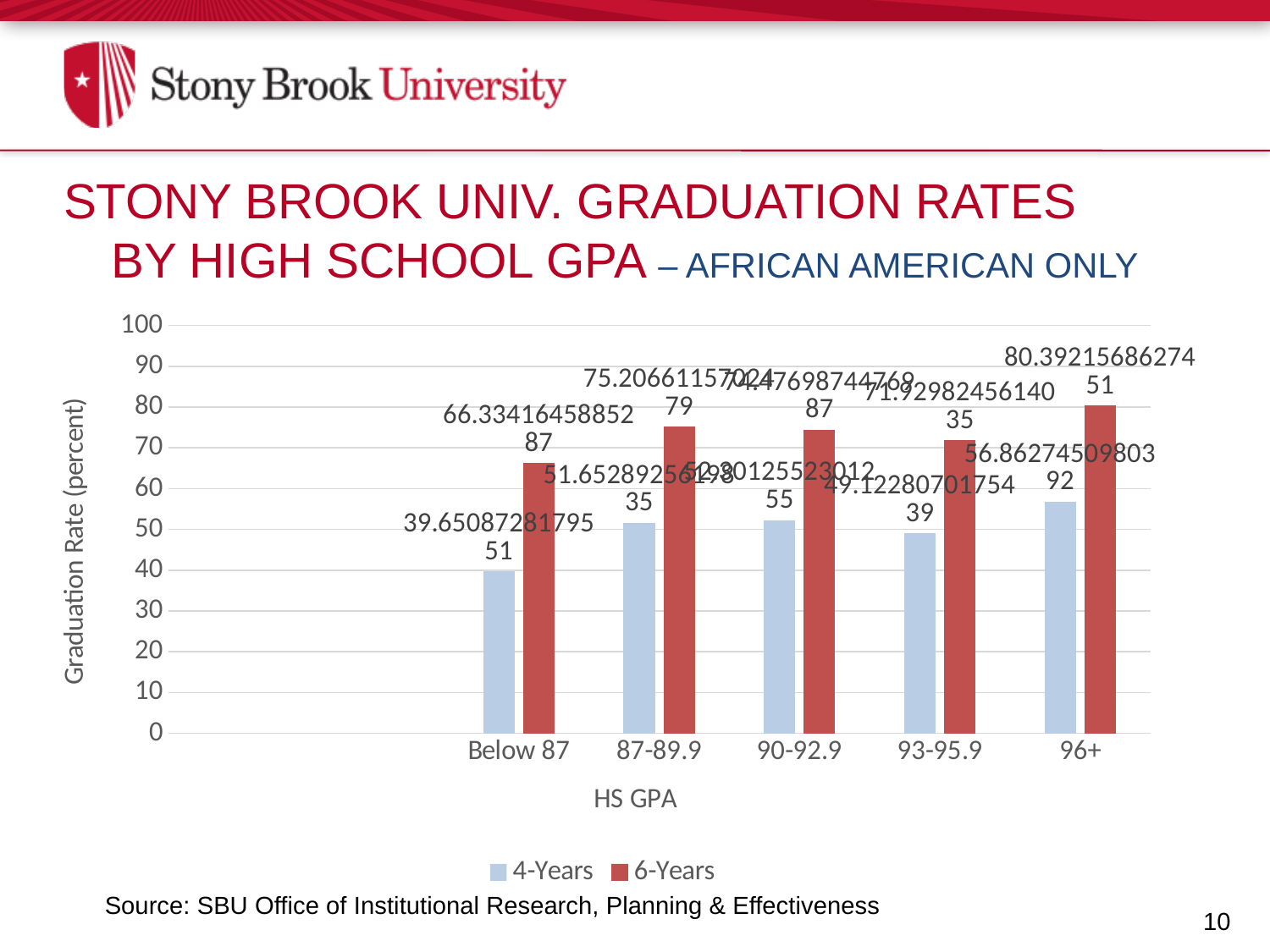
What is the 6-Years graduation rate for the Below 87 HS GPA group? 66.3341645885287 What type of chart is shown on the slide? Bar chart Is the 6-Years graduation rate for the 90-92.9 group greater or less than 70? greater What is the 4-Years graduation rate for the Below 87 HS GPA group? 39.6508728179551 Which is larger: the 4-Years graduation rate for Below 87 or for 96+? 96+ Which HS GPA group has the highest 6-Years graduation rate? 96+ What is the 6-Years graduation rate for the 96+ HS GPA group? 80.3921568627451 How many series does the legend list? 2 Which HS GPA group has the lowest 4-Years graduation rate? Below 87 How many HS GPA groups are shown on the x axis? 5 Which HS GPA group has the lowest 6-Years graduation rate? Below 87 What is the 4-Years graduation rate for the 96+ HS GPA group? 56.8627450980392